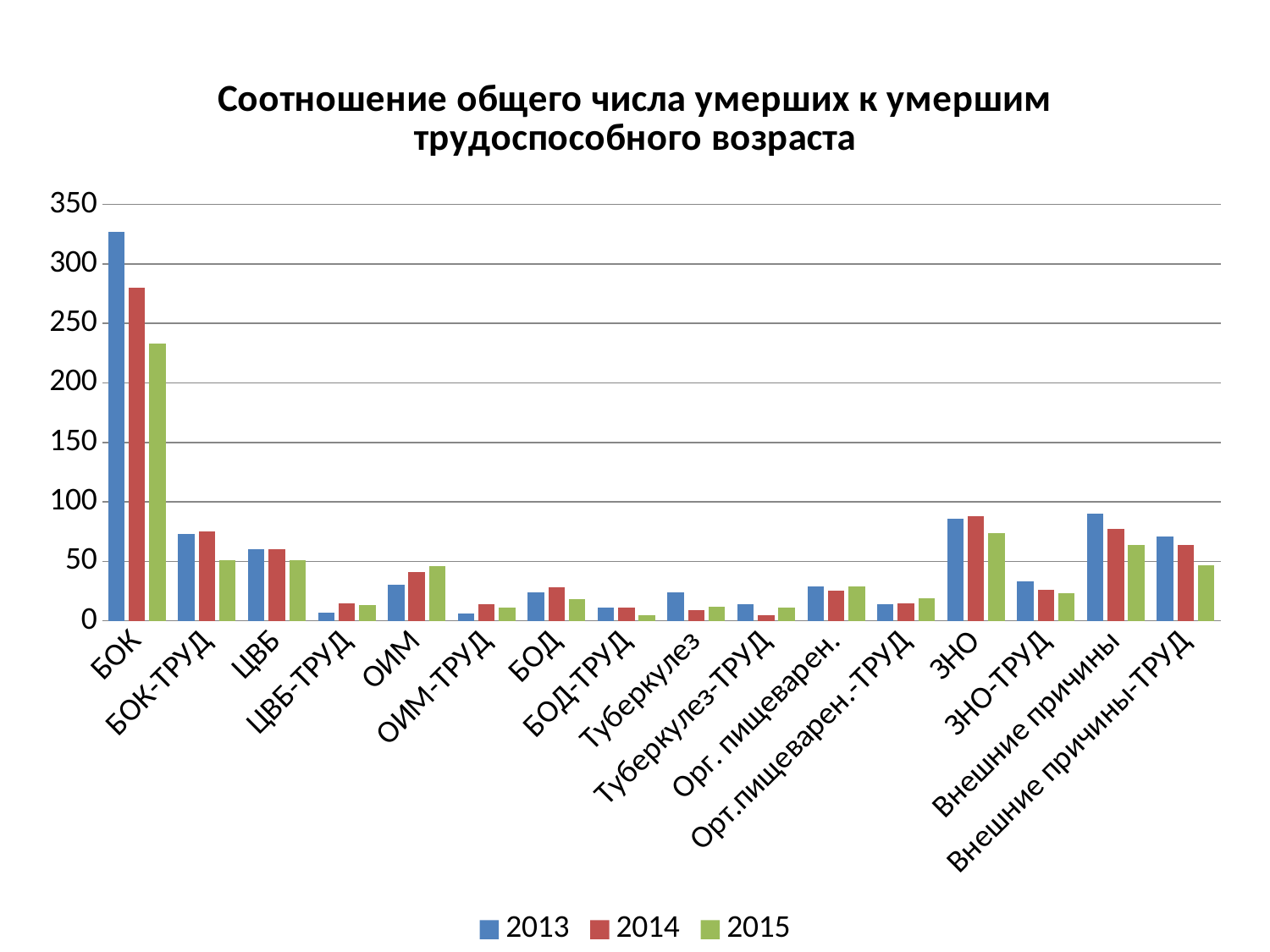
What kind of chart is shown on the slide? bar chart For БОК, do the values rise or fall from 2013 to 2015? fall Which category has the highest value for the 2013 series? БОК For ОИМ, do the values rise or fall from 2013 to 2015? rise How many categories are shown along the x axis? 16 For БОК, which series has the larger value, 2014 or 2015? 2014 How many series does the legend list? 3 What are the entries listed in the legend? 2013, 2014, 2015 Is the 2015 value for БОК greater or less than 250? less Is the 2013 value for БОК greater or less than 300? greater Which has the larger 2013 value, Внешние причины or ЗНО-ТРУД? Внешние причины Is the 2014 value for ЗНО greater or less than 100? less